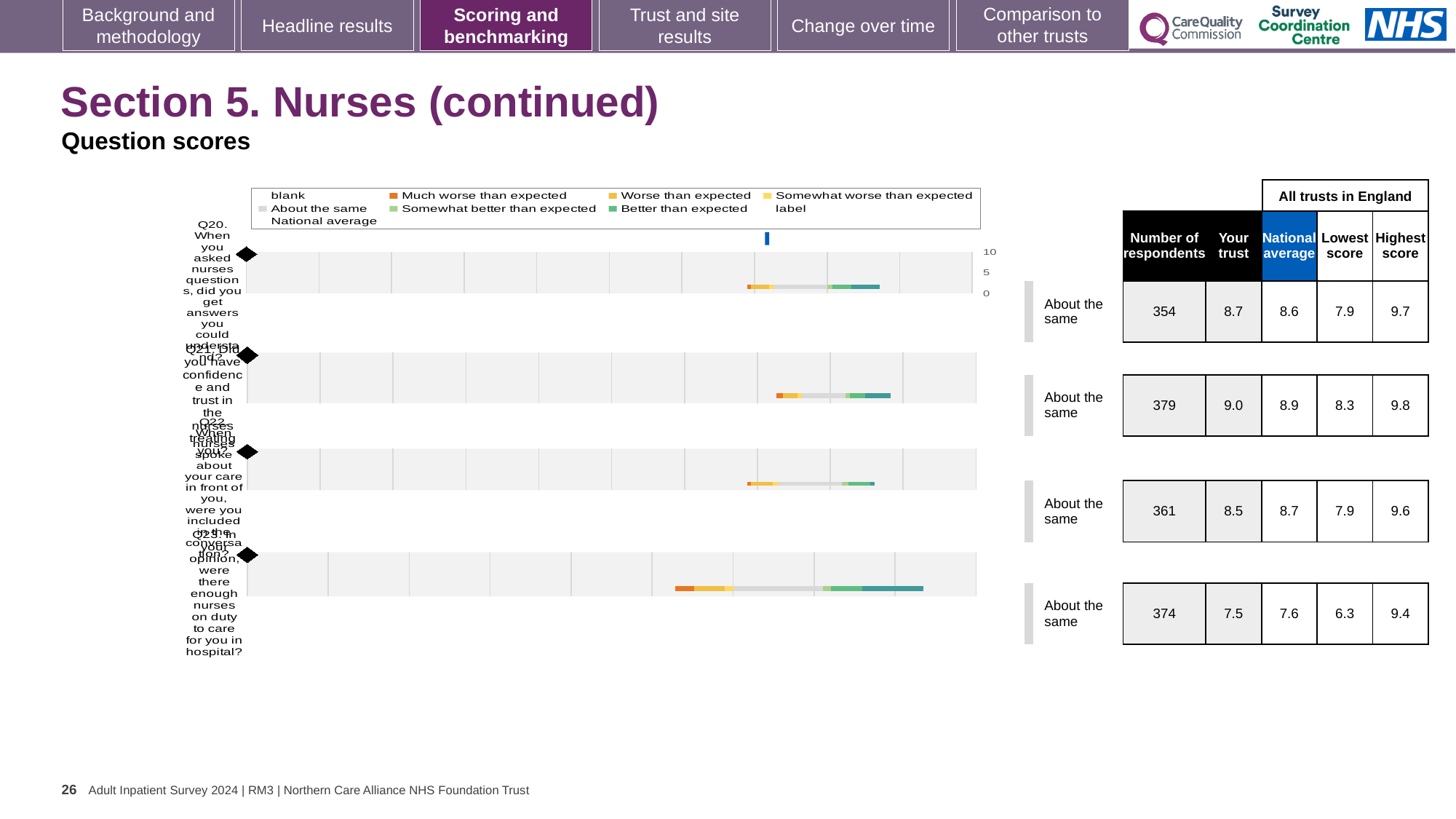
How many questions (rows) are plotted in the chart? 4 For Q22, which is larger: the 'Your trust' score or the national average? National average What is the 'Your trust' score for Q21 in the table next to the chart? 9.0 How many respondents are listed for Q22? 361 What is the highest score across all trusts in England for Q20? 9.7 How many entries does the chart legend list? 9 Which question has the highest 'Your trust' score? Q21 What kind of chart is shown on the slide? bar chart What is the national average for Q23 in the table next to the chart? 7.6 Which question has the lowest 'Your trust' score? Q23 Which legend entry is shown in orange (the first coloured entry after 'blank')? Much worse than expected What is the difference between the highest score and the lowest score for Q21? 1.5